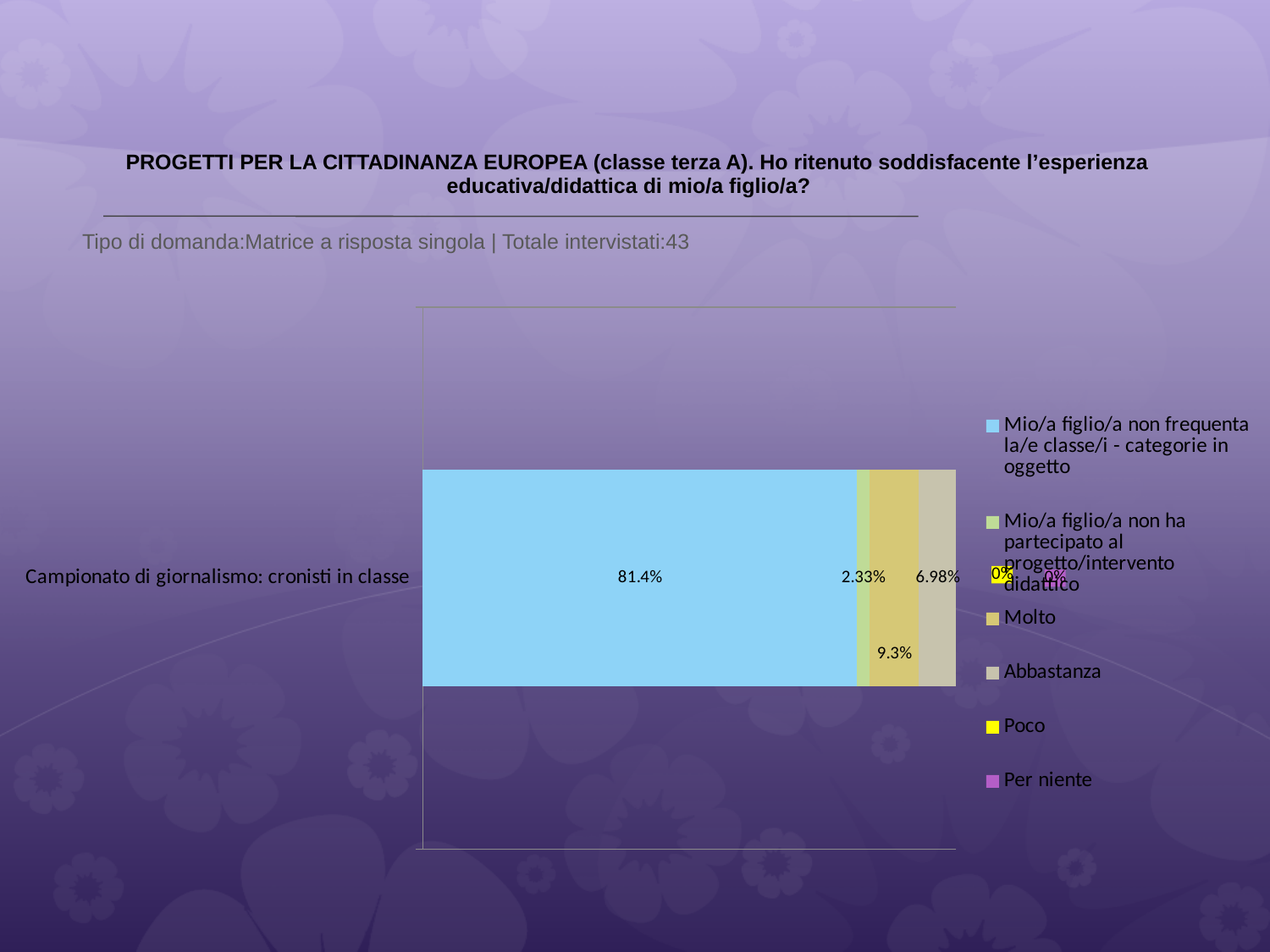
What is the difference between the value for 'Molto' and the value for 'Abbastanza'? 2.32% What is the value for 'Molto'? 9.3% How many series does the legend list? 6 What is the value for 'Mio/a figlio/a non ha partecipato al progetto/intervento didattico'? 2.33% What is the value for 'Poco'? 0% What is the value for 'Mio/a figlio/a non frequenta la/e classe/i - categorie in oggetto' for 'Campionato di giornalismo: cronisti in classe'? 81.4% How many categories are plotted on the chart? 1 Which series has the highest value in the bar? Mio/a figlio/a non frequenta la/e classe/i - categorie in oggetto What is the category label of the single bar on the chart? Campionato di giornalismo: cronisti in classe What kind of chart is shown on the slide? bar chart What is the value for 'Abbastanza'? 6.98% Which is larger, the value for 'Molto' or the value for 'Abbastanza'? Molto